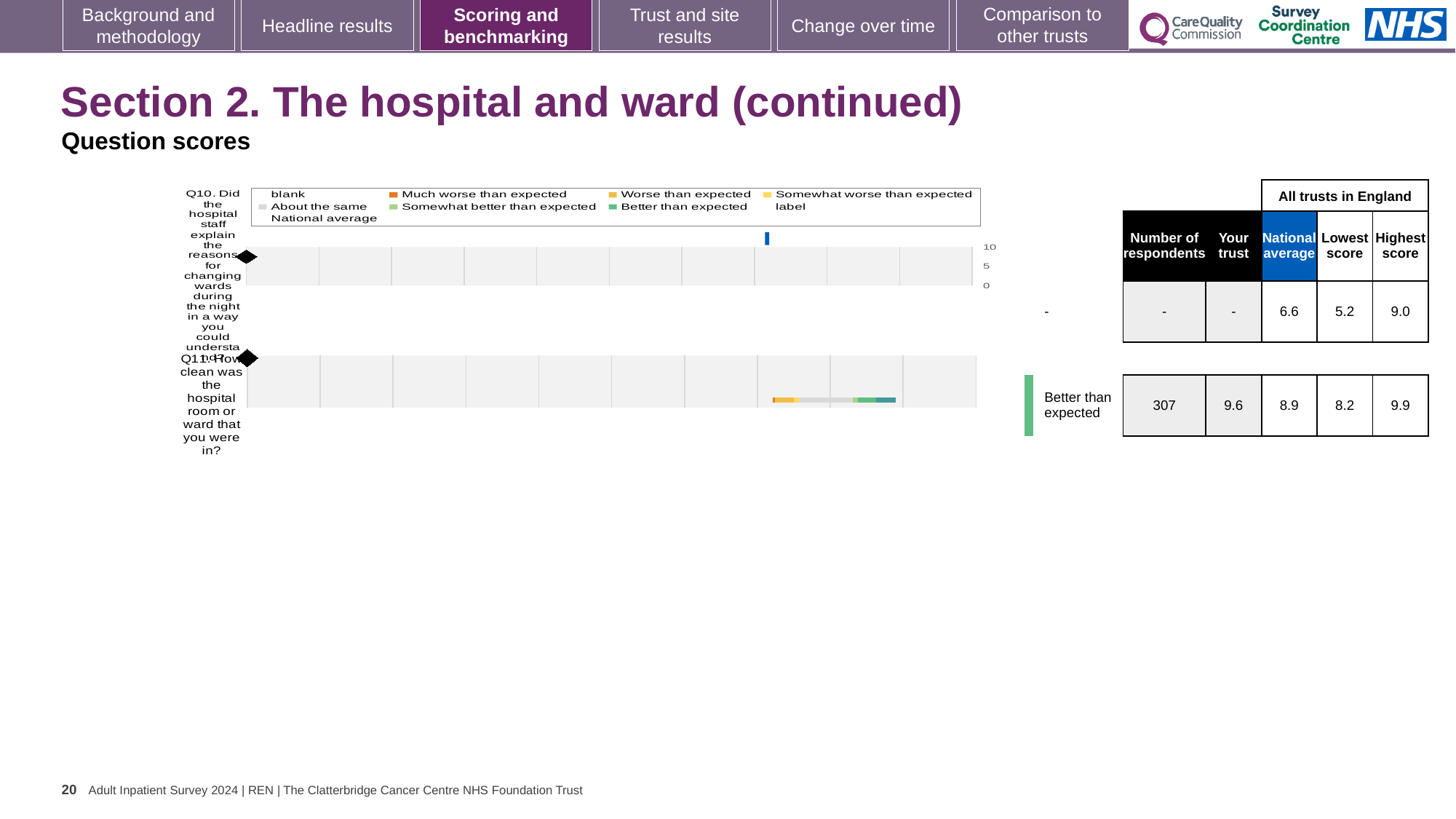
How many entries does the chart's legend list? 9 How many survey questions (categories) are plotted on the chart? 2 What is the lowest tick value shown on the chart's score axis? 0 What kind of chart is shown on the slide? bar chart What is the highest value shown on the chart's score axis? 10 Which question numbers are shown as categories on the chart? Q10 and Q11